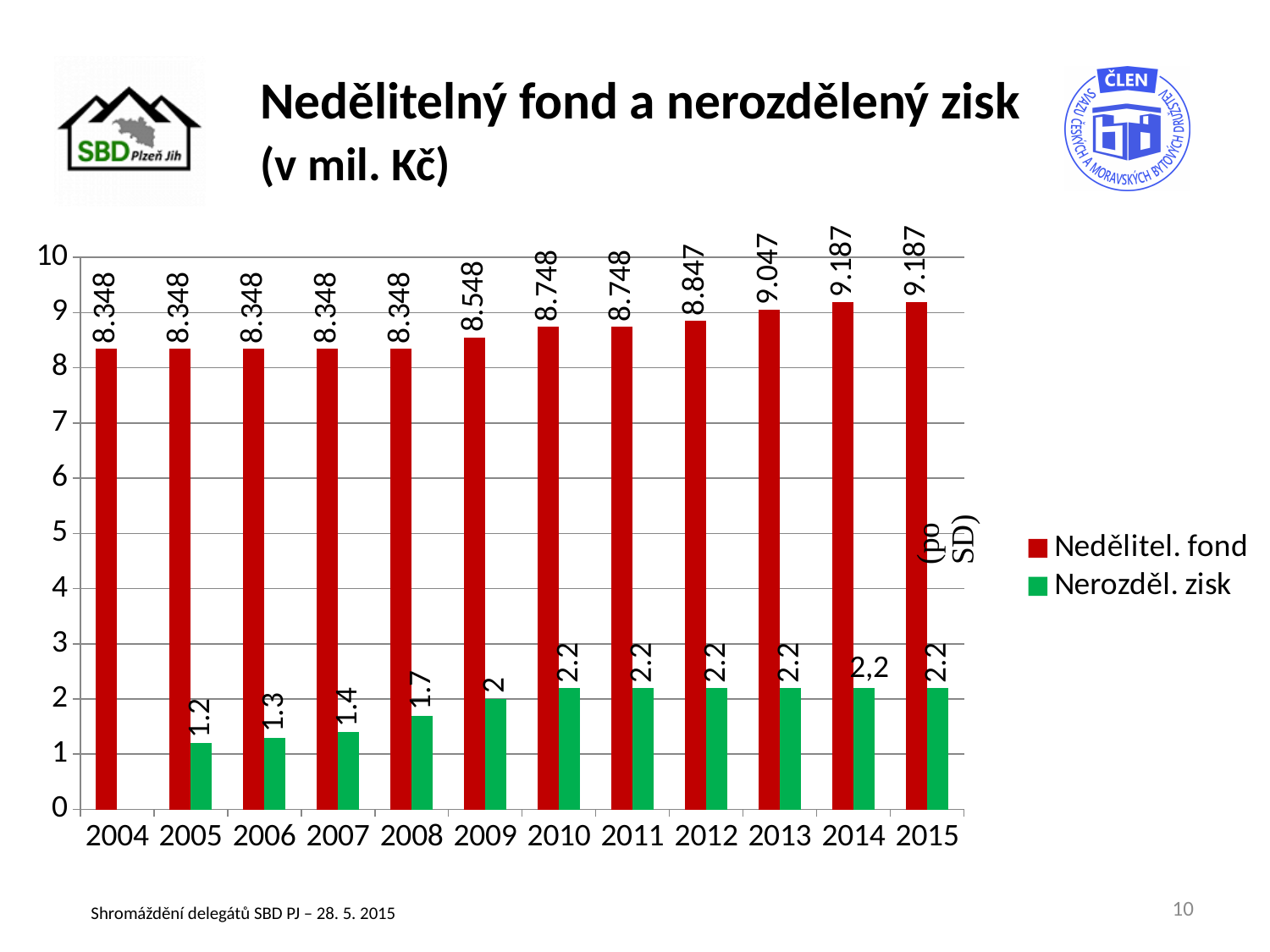
What is the value of Nerozděl. zisk for 2005? 1.2 What is the value of Nedělitel. fond for 2013? 9.047 How many series does the legend list? 2 Is the value of Nedělitel. fond for 2014 greater or less than 9? greater Which year has the lowest value of Nerozděl. zisk among the years where it is plotted? 2005 What is the value of Nerozděl. zisk for 2008? 1.7 What is the value of Nedělitel. fond for 2009? 8.548 Which is larger, the Nedělitel. fond value for 2012 or for 2010? 2012 How many years are shown on the x axis? 12 Does the Nedělitel. fond series rise or fall from 2008 to 2014? rise What is the difference between the Nedělitel. fond values for 2015 and 2004? 0.839 What kind of chart is shown on the slide? bar chart